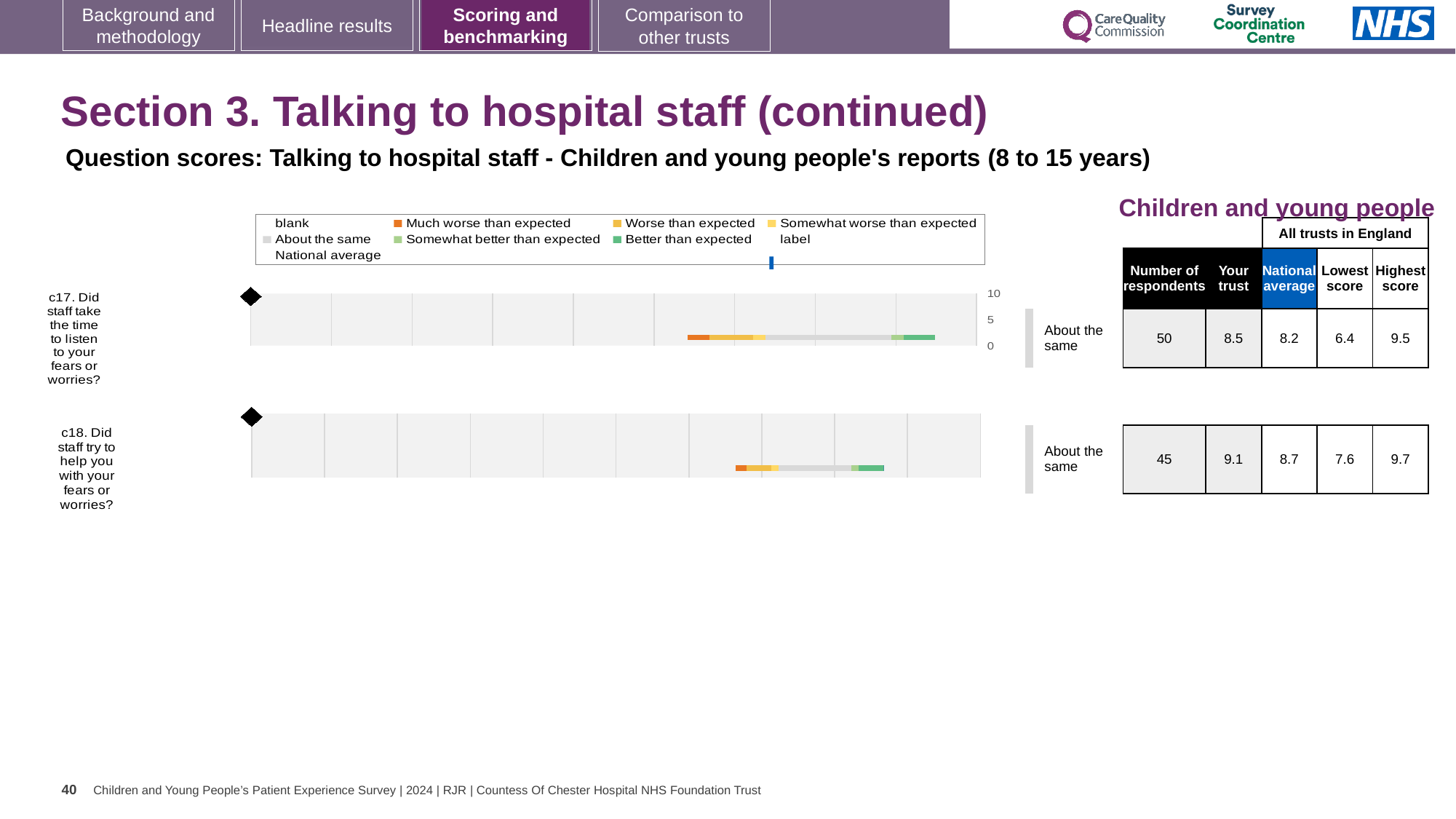
What kind of chart is used to show the question scores on this slide? bar chart What is the difference between the highest and lowest scores for c17? 3.1 How many respondents answered c17? 50 For c17 (Did staff take the time to listen to your fears or worries?), what is the score for your trust? 8.5 For c18 (Did staff try to help you with your fears or worries?), what is the score for your trust? 9.1 What is the difference between the trust score and the national average for c18? 0.4 Which question has the higher trust score, c17 or c18? c18 Is the trust score for c17 greater or less than 5 on the chart axis? greater For c17, what is the national average score? 8.2 How many questions (c17 and c18) are plotted on the slide? 2 For c18, what is the highest score among all trusts in England? 9.7 What benchmark category is the trust placed in for c18? About the same